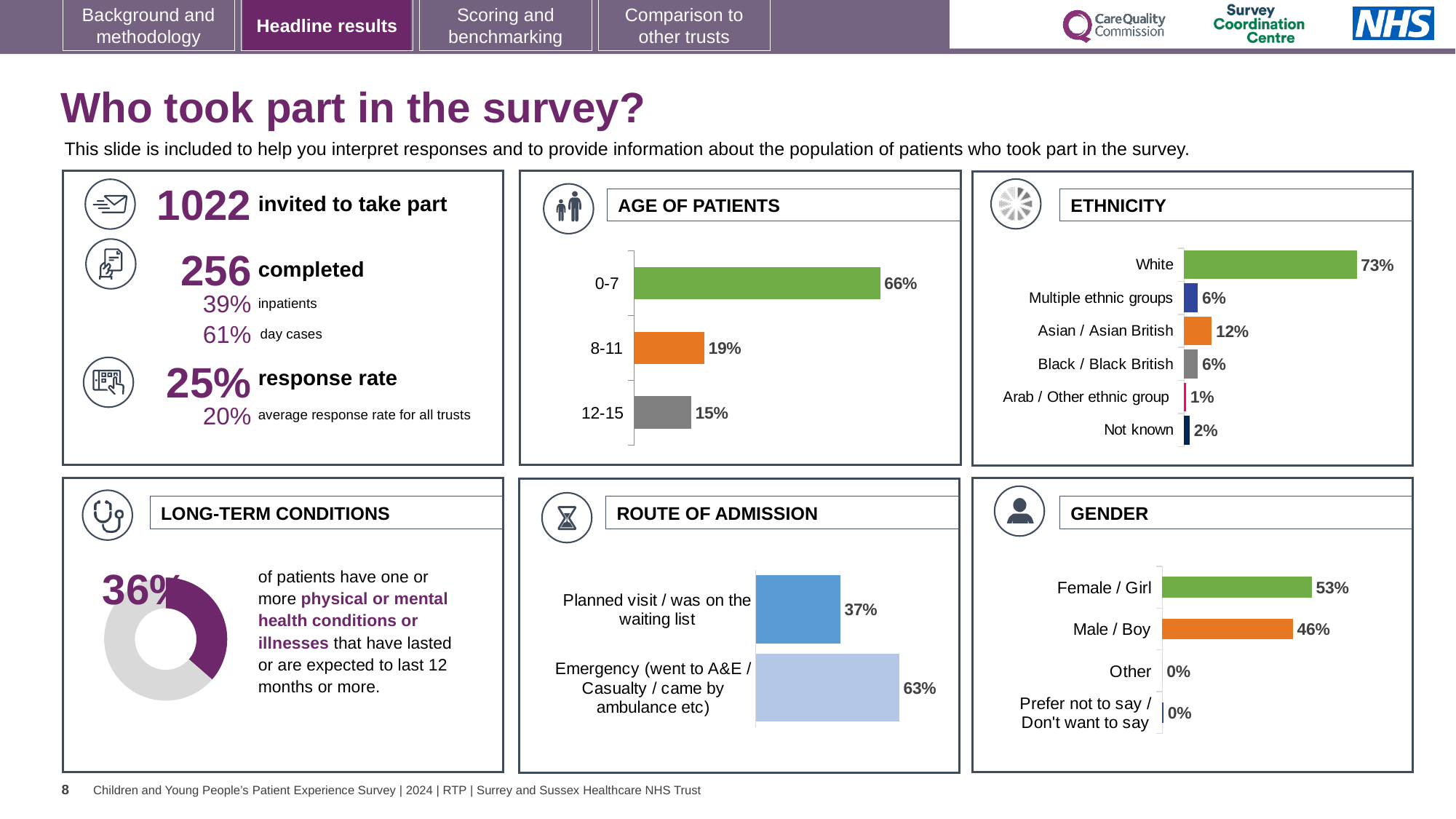
In the ROUTE OF ADMISSION chart, what percentage of patients came via Emergency (went to A&E / Casualty / came by ambulance etc)? 63% In the ETHNICITY chart, what percentage of patients were Asian / Asian British? 12% In the AGE OF PATIENTS chart, which age group has the lowest percentage? 12-15 In the GENDER chart, what is the difference between Female / Girl and Male / Boy? 7% How many categories are shown in the ETHNICITY chart? 6 In the GENDER chart, what percentage of patients were Male / Boy? 46% In the AGE OF PATIENTS chart, what is the difference between the 8-11 and 12-15 percentages? 4% What kind of chart is used in the LONG-TERM CONDITIONS panel? Doughnut chart In the ETHNICITY chart, which category has the highest percentage? White In the AGE OF PATIENTS chart, what percentage of patients were aged 0-7? 66% In the ROUTE OF ADMISSION chart, what is the difference between the Emergency and Planned visit percentages? 26% In the ETHNICITY chart, which is larger: Multiple ethnic groups or Not known? Multiple ethnic groups